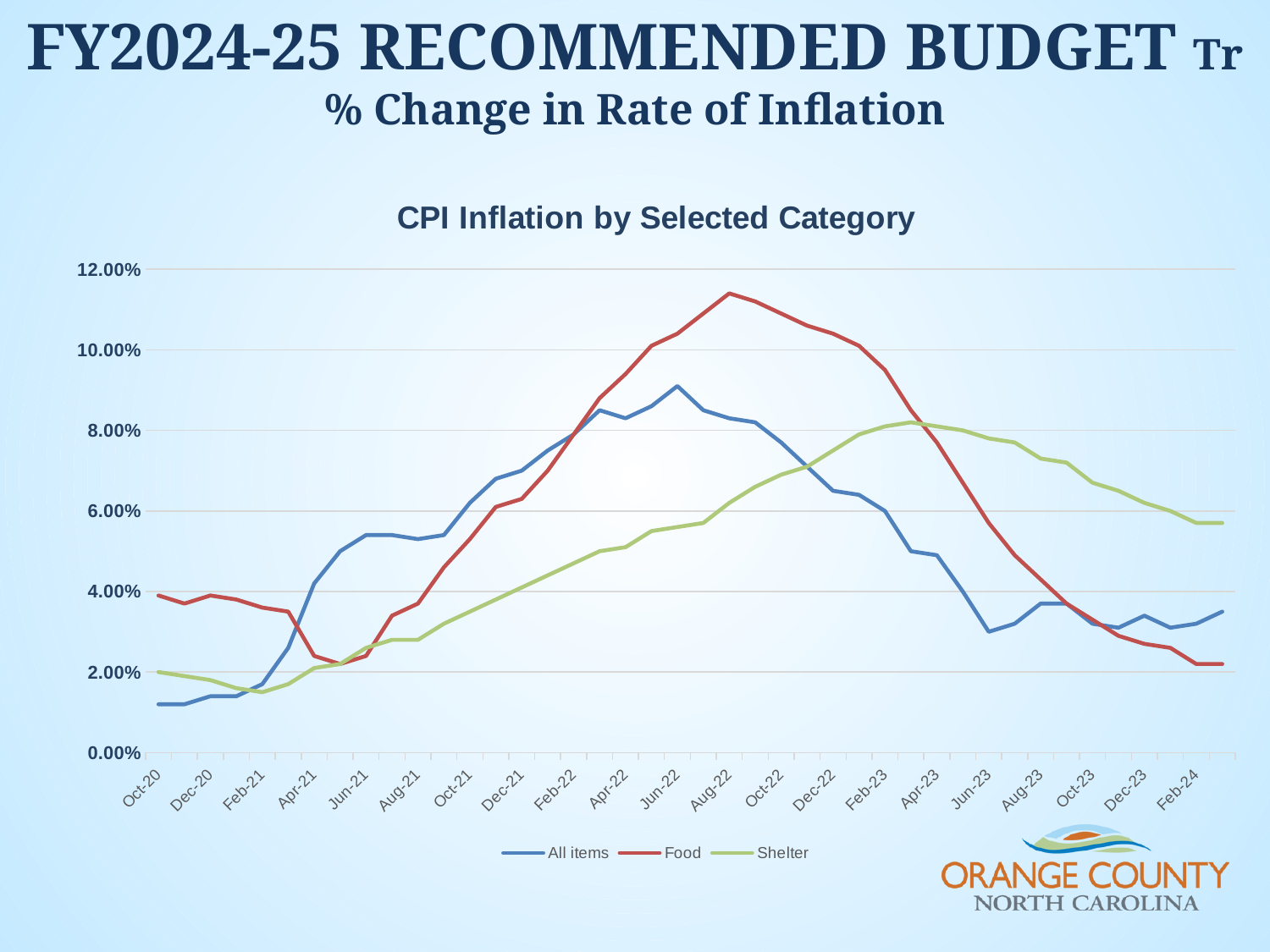
At Oct-20, which is higher: Food or All items? Food What is the title of the chart? CPI Inflation by Selected Category Is the value for All items at Oct-20 greater or less than 2.00%? less Is the value for All items at Jun-22 greater or less than 8.00%? greater What kind of chart is shown on the slide? Line chart Does the Food series rise or fall from Aug-22 to Feb-24? Fall What are the three series named in the legend? All items, Food, Shelter How many series does the legend list? 3 Is the value for Food at Aug-22 greater or less than 10.00%? greater Which series reaches the highest peak value on the chart? Food At Feb-24, which is higher: Shelter or Food? Shelter